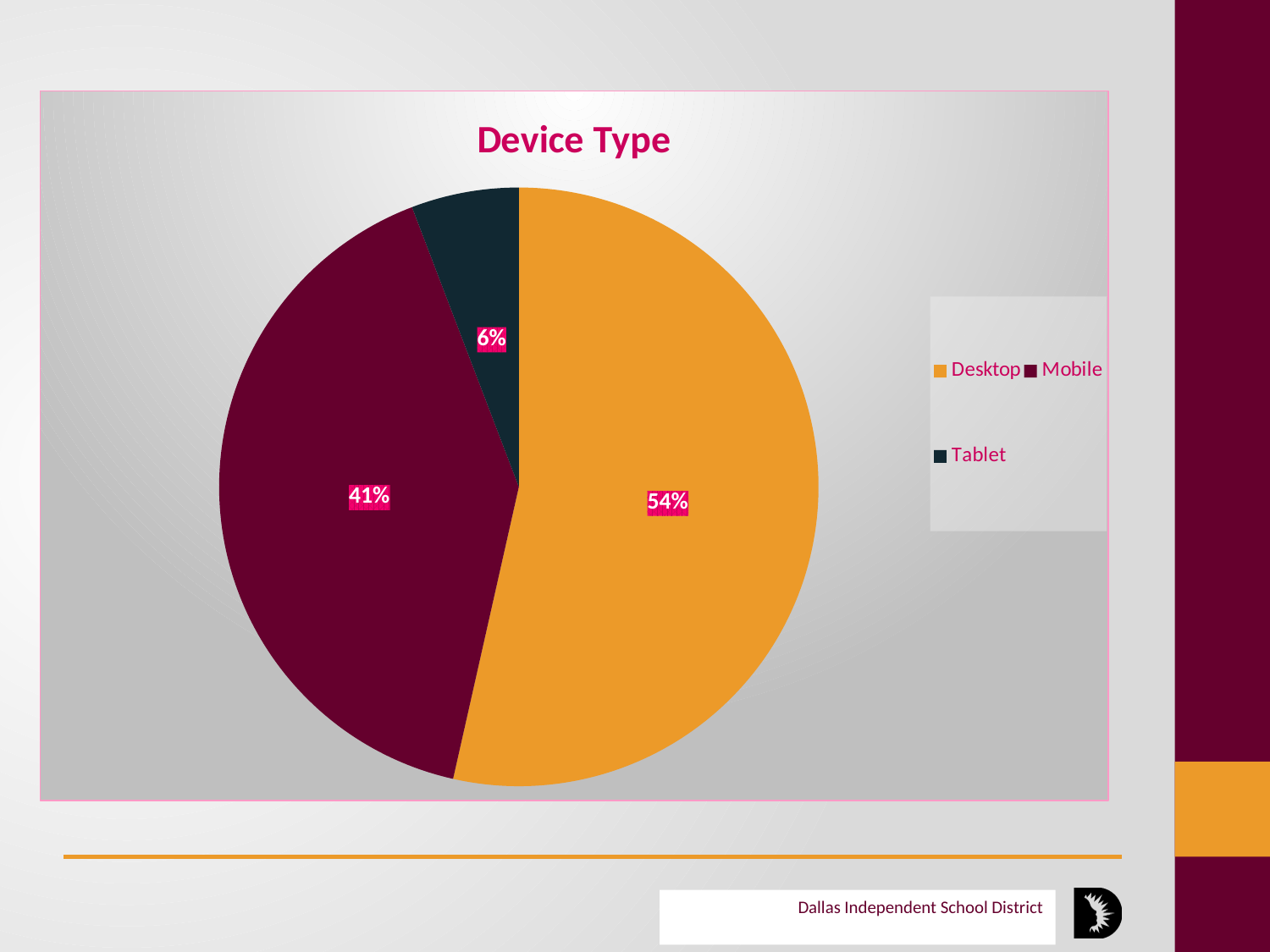
How many slices does the pie chart have? 3 Which is larger, the Mobile slice or the Tablet slice? Mobile What kind of chart is shown on the slide? pie chart What is the difference in percentage points between Mobile and Tablet? 35 Which colour represents Desktop in the legend? orange Which device type has the largest slice? Desktop Which device type has the smallest slice? Tablet What share of the pie does Tablet have? 6% What share of the pie does Mobile have? 41% What is the title of the chart? Device Type What is the difference in percentage points between Desktop and Mobile? 13 What share of the pie does Desktop have? 54%